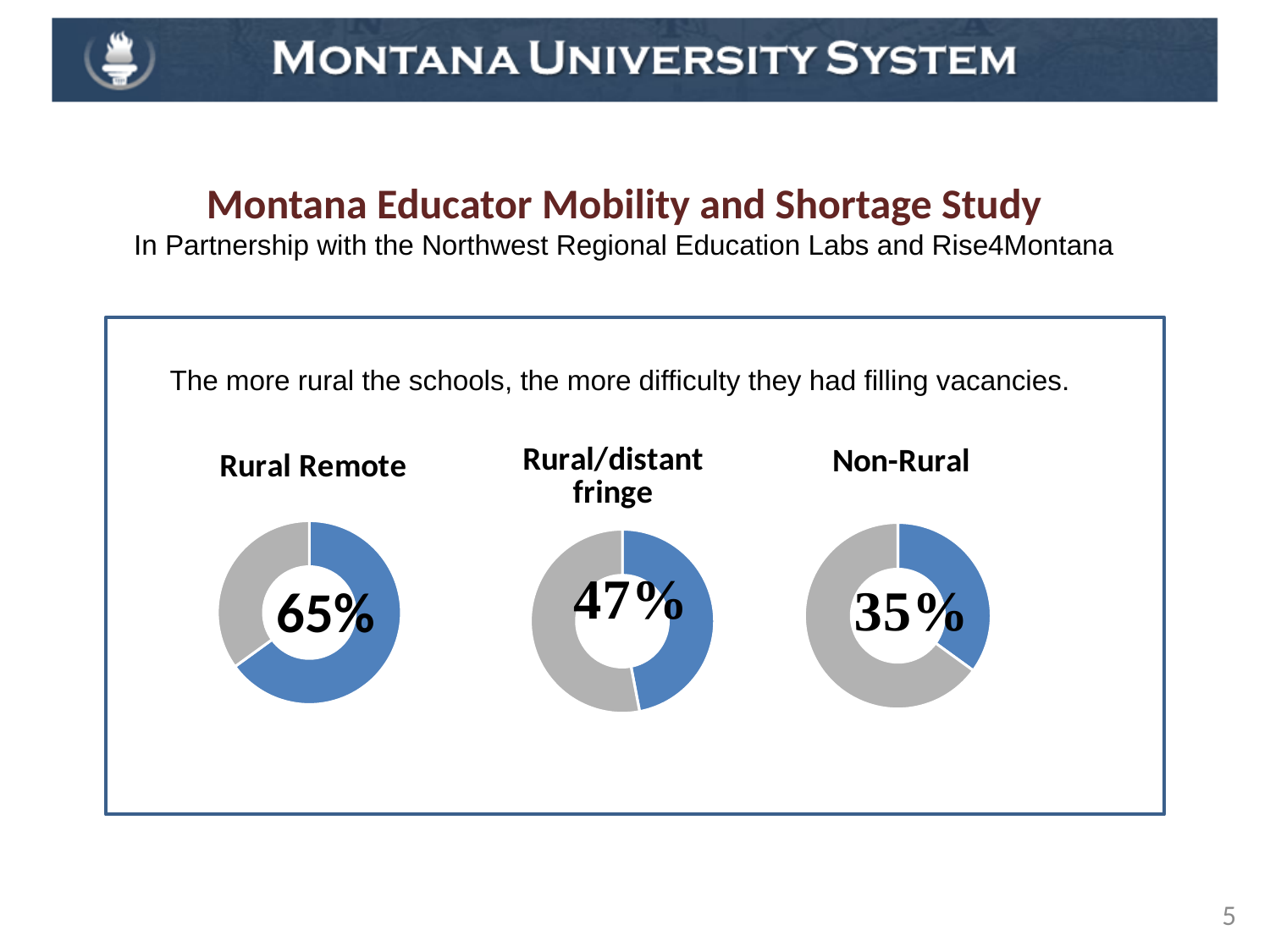
Reading the charts from left to right (Rural Remote, Rural/distant fringe, Non-Rural), do the percentages rise or fall? Fall What kind of chart is used to show the Rural Remote value? Doughnut chart What is the difference between the percentage in the Rural Remote chart and the percentage in the Non-Rural chart? 30% In the Non-Rural chart, what colour is the slice representing the 35% value? Blue In the Rural Remote chart, what percentage is shown in the centre of the doughnut? 65% In the Rural/distant fringe chart, what percentage is shown in the centre of the doughnut? 47% Which of the three doughnut charts shows the lowest percentage? Non-Rural Which of the three doughnut charts shows the highest percentage? Rural Remote What is the difference between the percentage in the Rural Remote chart and the percentage in the Rural/distant fringe chart? 18% In the Non-Rural chart, what percentage is shown in the centre of the doughnut? 35% How many doughnut charts are shown on the slide? 3 Which is larger: the percentage in the Rural/distant fringe chart or the percentage in the Non-Rural chart? Rural/distant fringe